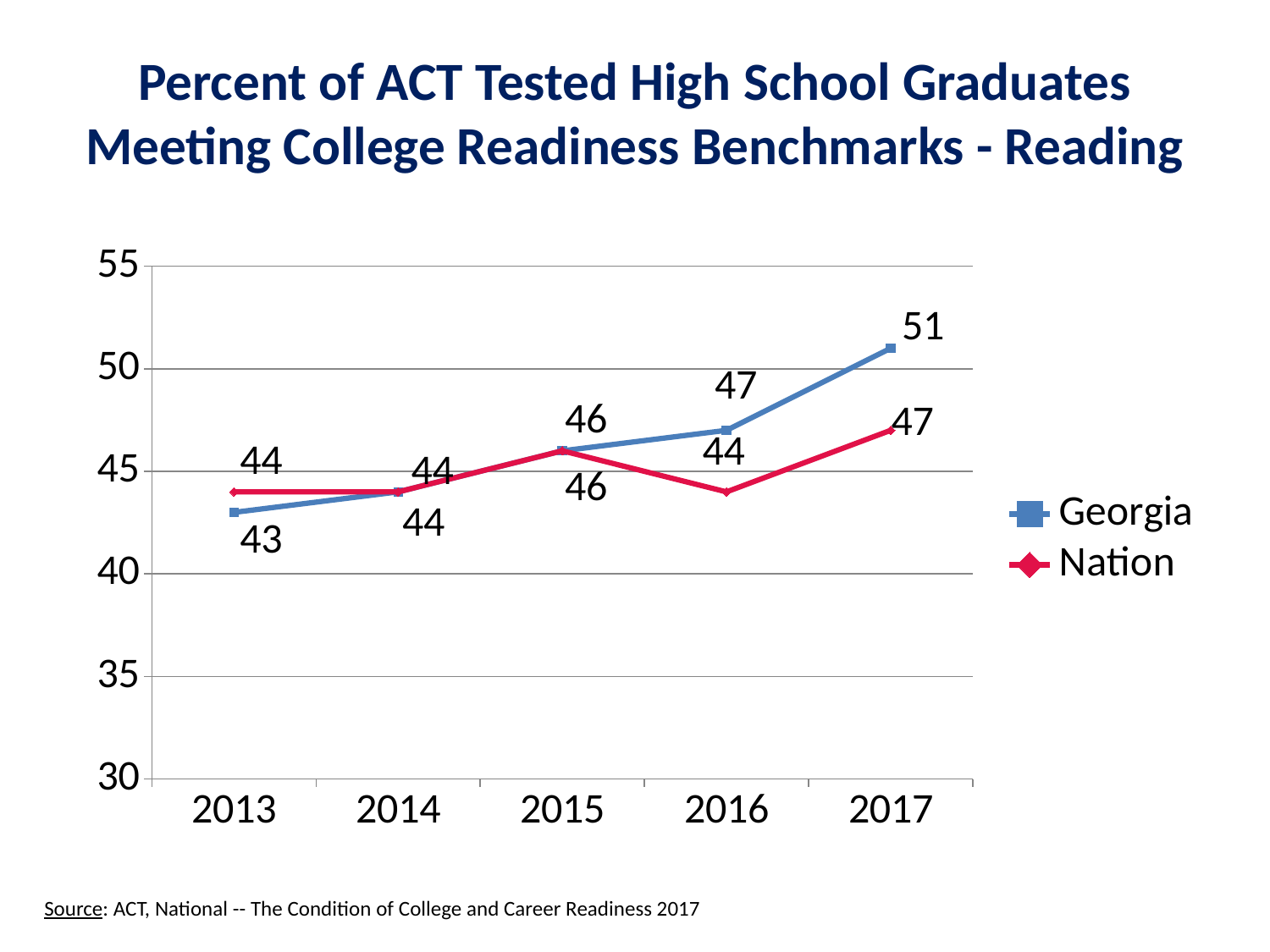
What is the difference between the Georgia and Nation values in 2017? 4 How many series does the legend list? 2 What is the value for Nation in 2017? 47 In which year is the Georgia value lowest? 2013 How many years are shown on the x axis? 5 In which year is the Georgia value highest? 2017 What is the value for Georgia in 2017? 51 What is the value for Georgia in 2013? 43 What kind of chart is shown on the slide? Line chart What is the value for Nation in 2016? 44 Is the value for Georgia in 2017 greater or less than 50? greater Which is larger in 2016, the Georgia value or the Nation value? Georgia